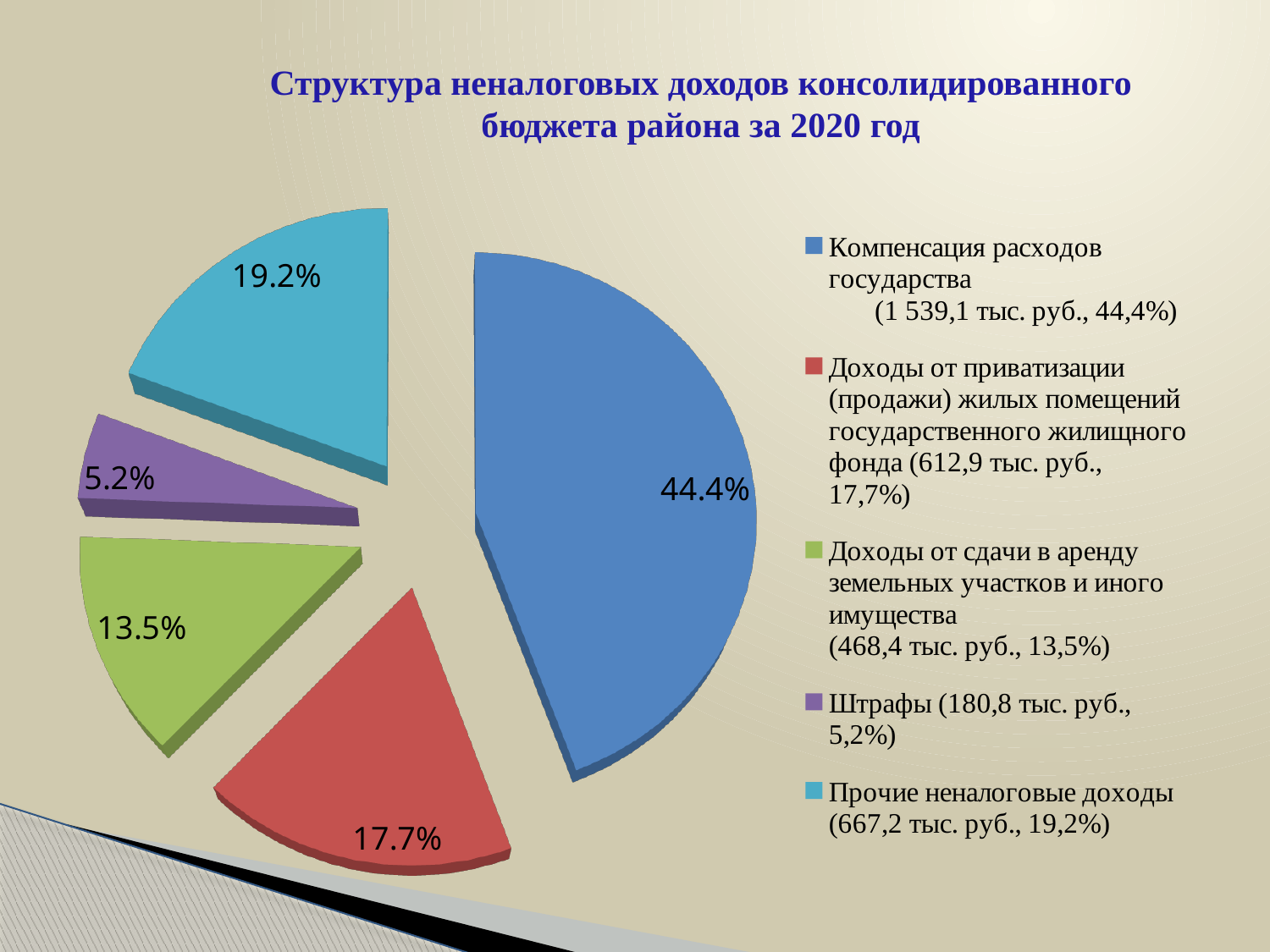
What share of the pie does "Прочие неналоговые доходы" represent? 19.2% What is the difference in percentage points between the "Компенсация расходов государства" slice and the "Доходы от приватизации (продажи) жилых помещений государственного жилищного фонда" slice? 26.7 According to the legend, what amount in thousand rubles corresponds to "Штрафы"? 180,8 тыс. руб. What share of the pie does "Компенсация расходов государства" represent? 44.4% What colour is the slice for "Доходы от сдачи в аренду земельных участков и иного имущества"? Green What share of the pie does "Штрафы" represent? 5.2% What type of chart is shown on the slide? Pie chart Which category has the smallest slice of the pie? Штрафы Which category has the largest slice of the pie? Компенсация расходов государства Which is larger: the share for "Прочие неналоговые доходы" or the share for "Доходы от приватизации (продажи) жилых помещений государственного жилищного фонда"? Прочие неналоговые доходы How many slices does the pie chart have? 5